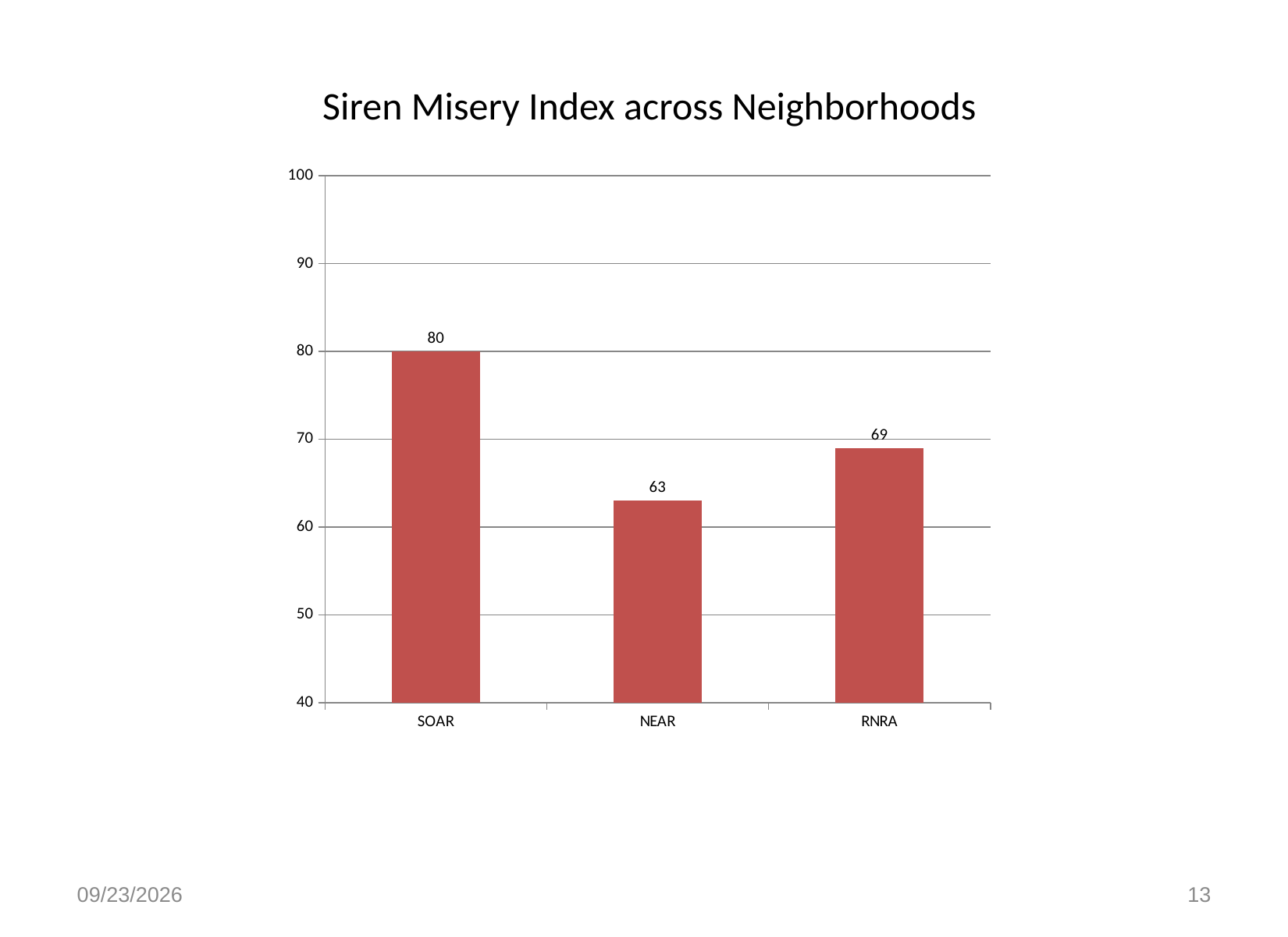
What is the difference between the Siren Misery Index for SOAR and NEAR? 17 How many neighborhoods are shown in the chart? 3 Is the value for RNRA greater or less than 70? less What is the Siren Misery Index value for SOAR? 80 What is the Siren Misery Index value for NEAR? 63 Which has a higher Siren Misery Index, NEAR or RNRA? RNRA What is the title of the chart? Siren Misery Index across Neighborhoods What is the Siren Misery Index value for RNRA? 69 What kind of chart is shown on the slide? bar chart Which neighborhood has the highest Siren Misery Index? SOAR Which neighborhood has the lowest Siren Misery Index? NEAR What is the difference between the Siren Misery Index for RNRA and NEAR? 6